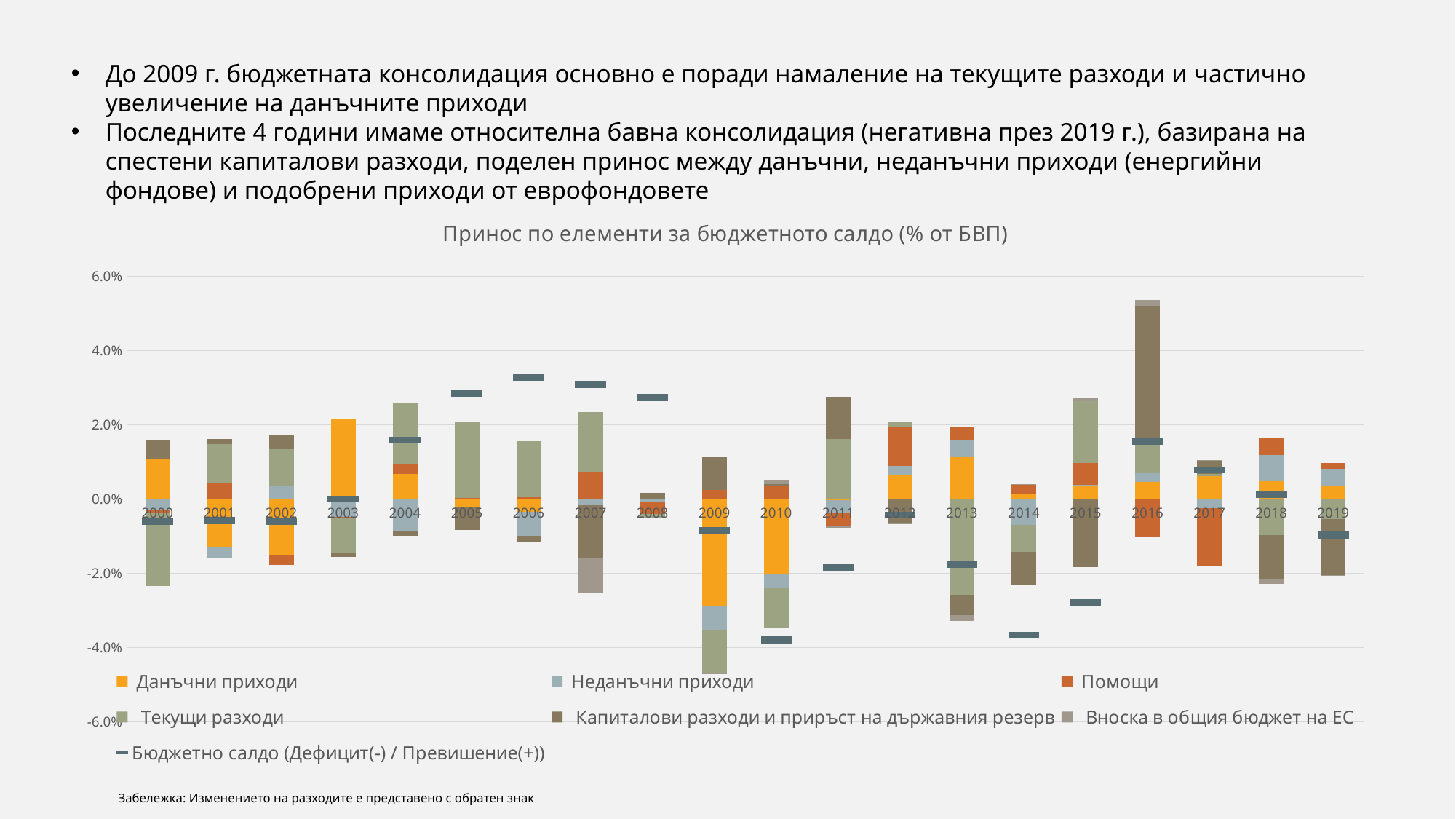
What is the title of the chart? Принос по елементи за бюджетното салдо (% от БВП) Which legend entry is shown in orange/yellow? Данъчни приходи Which year is the last category on the x axis? 2019 Is the budget balance (Бюджетно салдо) marker for 2019 greater or less than 0.0%? less Is the budget balance (Бюджетно салдо) marker for 2010 greater or less than -2.0%? less What kind of chart is shown on the slide? Stacked bar chart with a budget balance marker series Is the budget balance (Бюджетно салдо) marker for 2006 greater or less than 2.0%? greater Which year has the larger budget balance (Бюджетно салдо) marker, 2006 or 2010? 2006 How many series does the chart legend list? 7 Which year is the first category on the x axis? 2000 How many years are shown on the x axis of the chart? 20